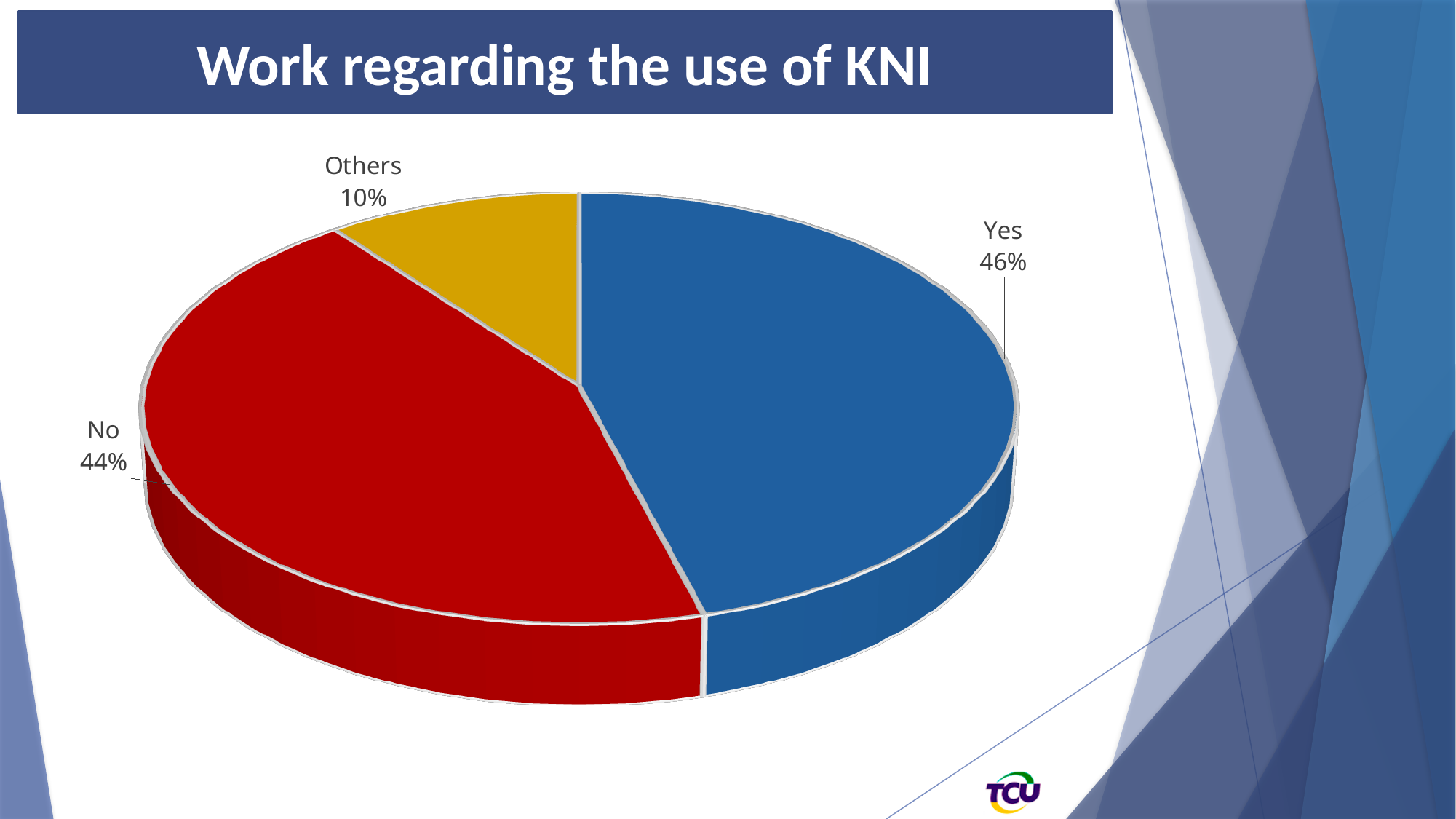
What colour is the "Others" slice of the pie? Yellow What kind of chart is shown on the slide? Pie chart What is the difference in percentage points between the "No" and "Others" slices? 34% What share of the pie is labelled "Others"? 10% What is the title of the slide containing the chart? Work regarding the use of KNI Which is larger, the "No" slice or the "Others" slice? No What is the difference in percentage points between the "Yes" and "No" slices? 2% Which slice of the pie is the smallest? Others How many slices does the pie chart have? 3 What share of the pie is labelled "Yes"? 46% What share of the pie is labelled "No"? 44% Which slice of the pie is the largest? Yes